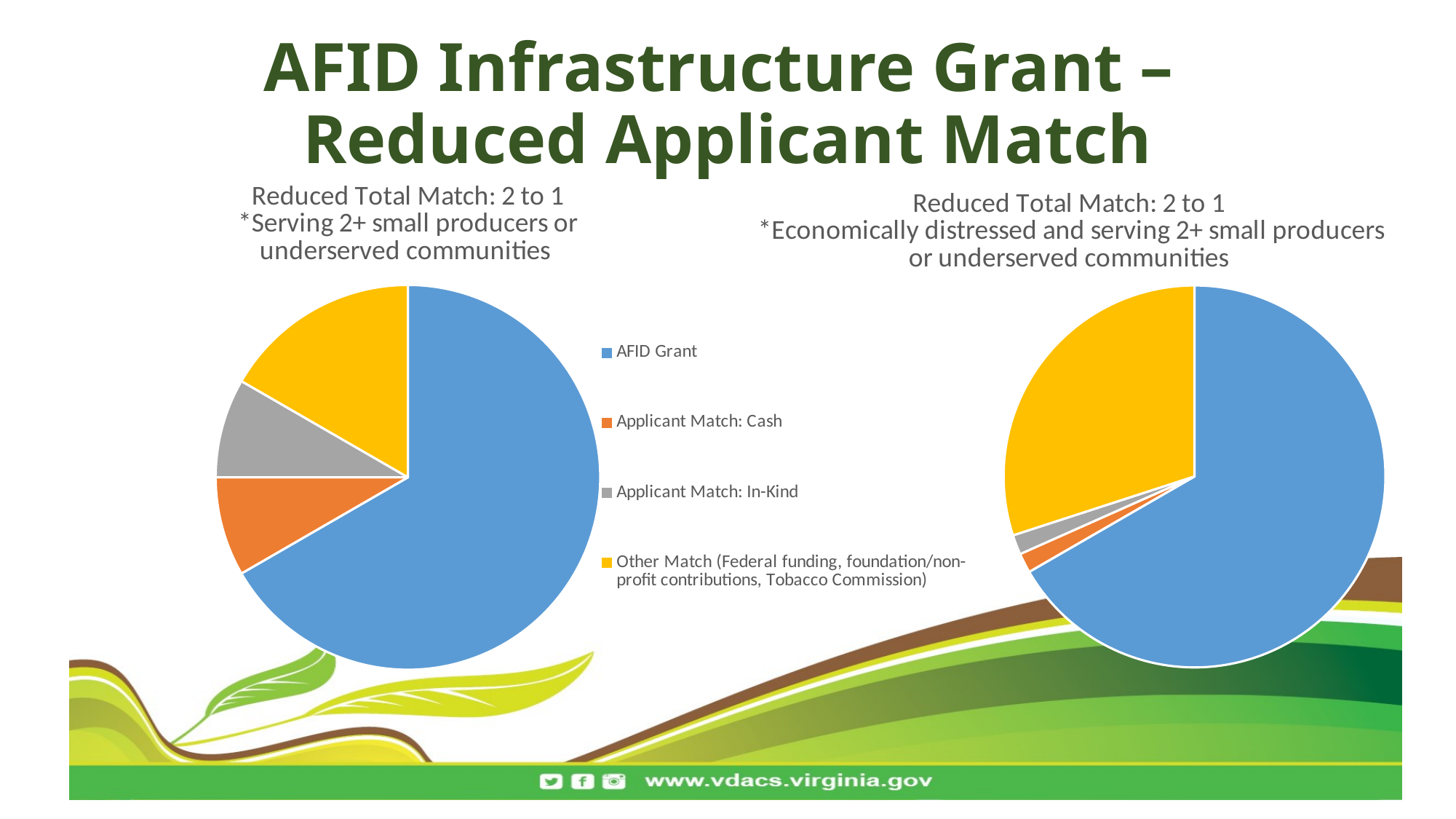
In the right pie chart (Economically distressed and serving 2+ small producers or underserved communities), which slice is larger: Other Match or Applicant Match: Cash? Other Match What kind of chart is the left chart, titled "Reduced Total Match: 2 to 1 *Serving 2+ small producers or underserved communities"? Pie chart In the left pie chart (Serving 2+ small producers or underserved communities), which category has the largest slice? AFID Grant In the right pie chart (Economically distressed and serving 2+ small producers or underserved communities), which category has the largest slice? AFID Grant Which colour represents AFID Grant in the legend shared by the two pie charts? Blue How many slices does the right pie chart (Economically distressed and serving 2+ small producers or underserved communities) have? 4 How many entries does the shared legend between the two pie charts list? 4 What is the main title of the slide containing the two pie charts? AFID Infrastructure Grant – Reduced Applicant Match In the right pie chart (Economically distressed and serving 2+ small producers or underserved communities), which slice is larger: AFID Grant or Other Match? AFID Grant In the left pie chart (Serving 2+ small producers or underserved communities), which slice is larger: Other Match or Applicant Match: Cash? Other Match